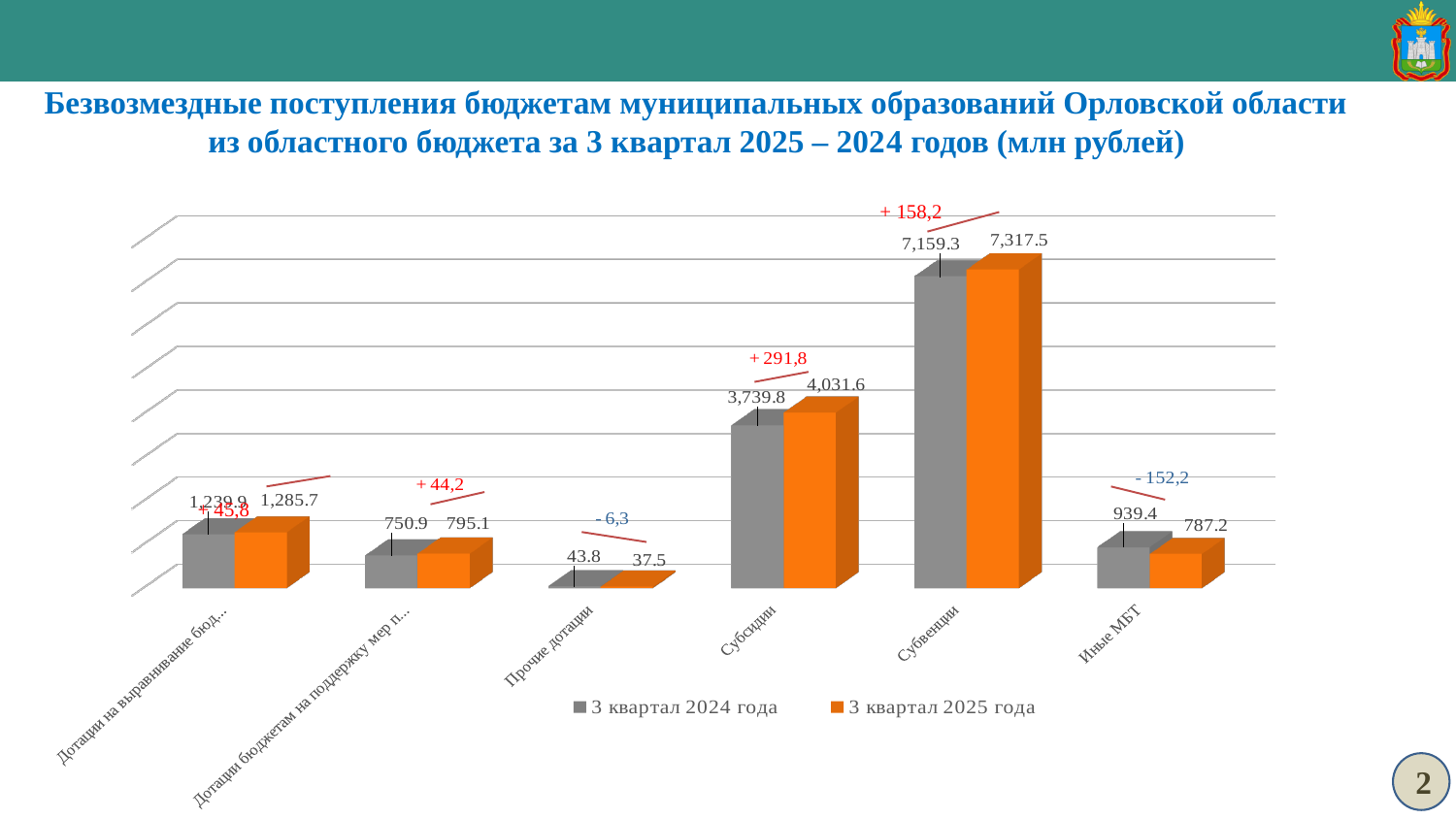
Which colour represents the series 3 квартал 2025 года? orange Which category has the highest value in 3 квартал 2025 года? Субвенции Which category has the lowest value in 3 квартал 2024 года? Прочие дотации What is the value for Прочие дотации in 3 квартал 2025 года? 37.5 How many series does the legend list? 2 What is the value for Субвенции in 3 квартал 2025 года? 7,317.5 For Иные МБТ, which is larger: the 3 квартал 2024 года value or the 3 квартал 2025 года value? 3 квартал 2024 года What is the difference between the 3 квартал 2025 года and 3 квартал 2024 года values for Субсидии? 291.8 What type of chart is shown on the slide? bar chart What is the value for Субсидии in 3 квартал 2024 года? 3,739.8 How many categories are shown on the x axis? 6 What is the value for Иные МБТ in 3 квартал 2024 года? 939.4